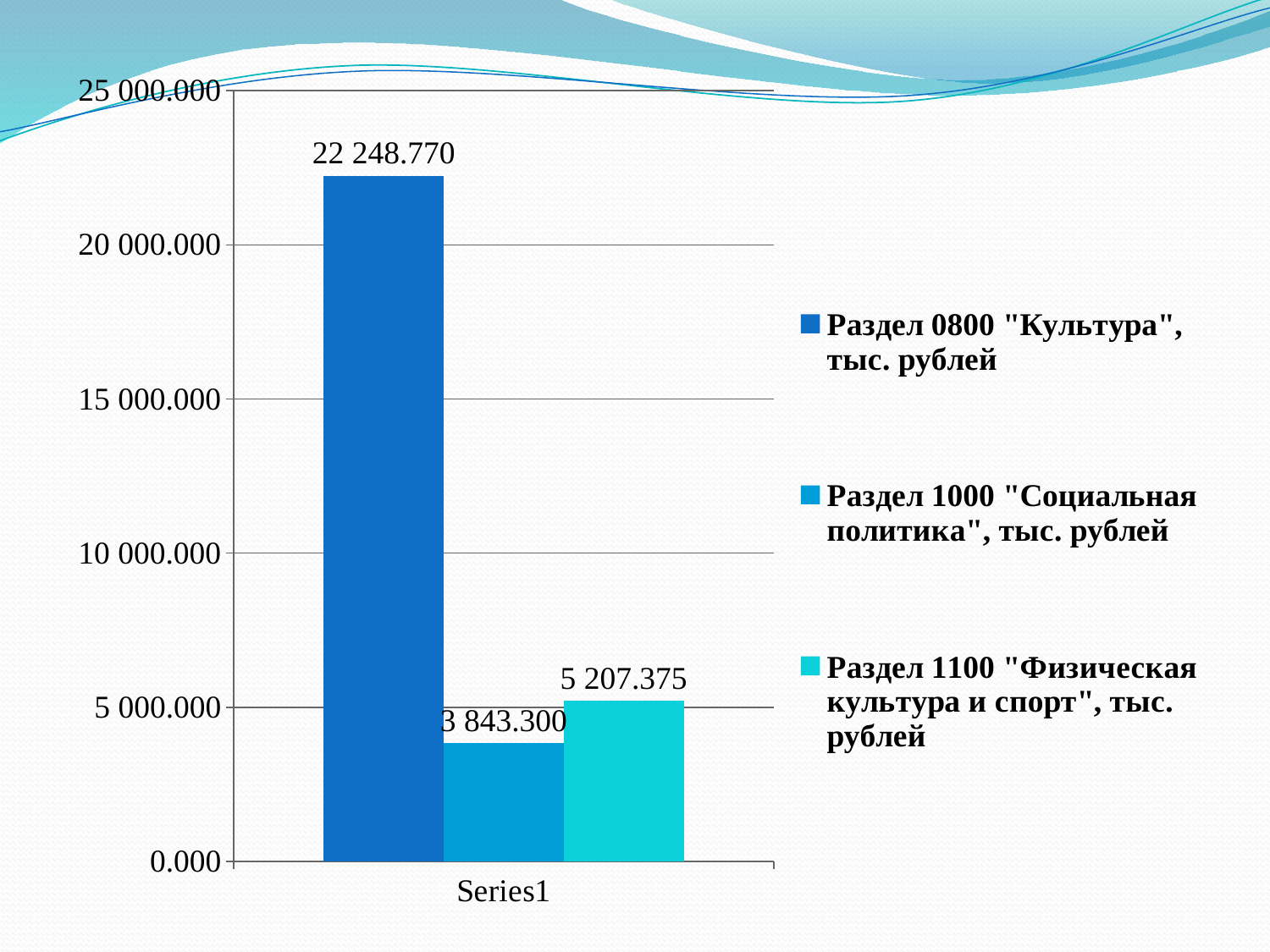
What is the difference between the values for Раздел 1100 "Физическая культура и спорт" and Раздел 1000 "Социальная политика"? 1 364.075 Is the value for Раздел 0800 "Культура" greater or less than 20 000.000? greater Which series has the highest value? Раздел 0800 "Культура" What is the value for Раздел 1000 "Социальная политика"? 3 843.300 What is the value for Раздел 1100 "Физическая культура и спорт"? 5 207.375 Which is larger, the value for Раздел 1100 "Физическая культура и спорт" or the value for Раздел 1000 "Социальная политика"? Раздел 1100 "Физическая культура и спорт" What kind of chart is shown on the slide? bar chart How many series does the legend list? 3 What is the difference between the values for Раздел 0800 "Культура" and Раздел 1000 "Социальная политика"? 18 405.470 Which series has the lowest value? Раздел 1000 "Социальная политика" What is the category label shown on the x axis? Series1 What is the value for Раздел 0800 "Культура"? 22 248.770